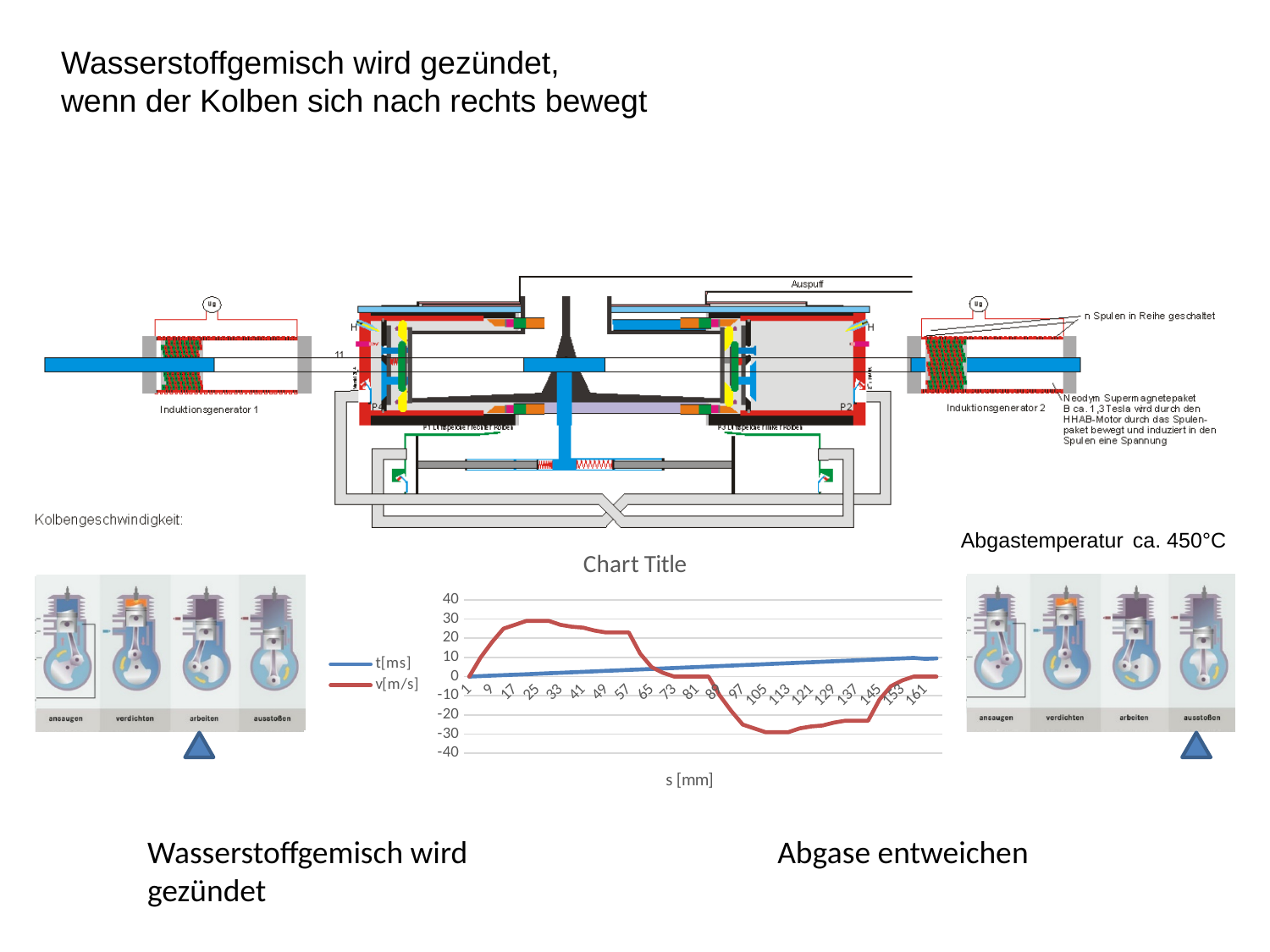
What are the two series named in the chart legend? t[ms] and v[m/s] At s = 105, which series has the larger value, t[ms] or v[m/s]? t[ms] At s = 33, which series has the larger value, t[ms] or v[m/s]? v[m/s] Is the value of t[ms] at s = 81 greater or less than 10? less What is the label of the chart's x axis? s [mm] Which series reaches the highest value anywhere on the chart? v[m/s] Is the value of v[m/s] at s = 33 greater or less than 20? greater How many series does the chart legend list? 2 What kind of chart is shown on the slide? line chart Is the value of t[ms] at s = 161 greater or less than 0? greater Does the t[ms] series rise or fall as s increases along the x axis? rise